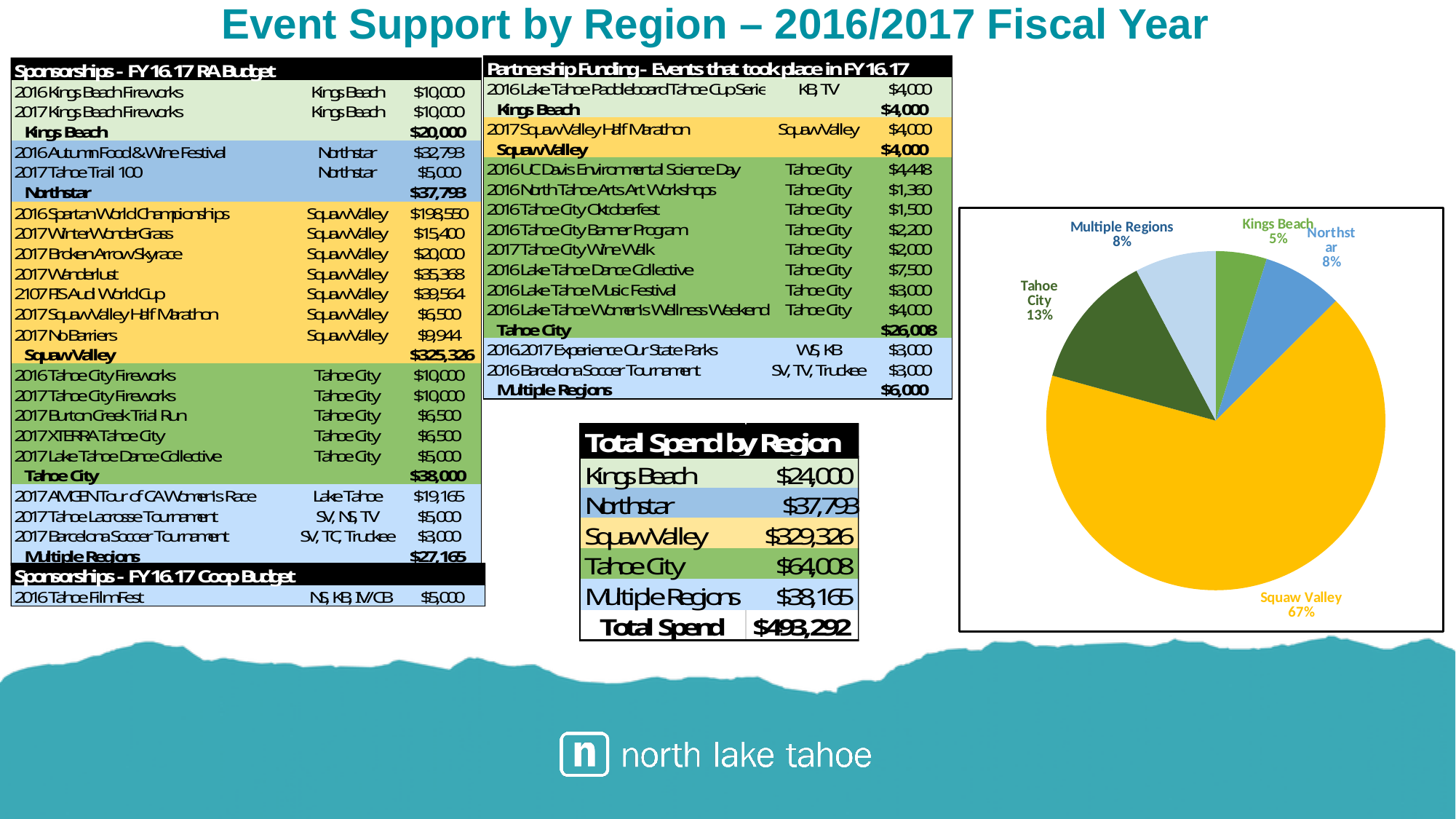
Which region has the smallest slice in the pie chart? Kings Beach Which region has the largest slice in the pie chart? Squaw Valley What share of the pie chart does Tahoe City represent? 13% In the pie chart, what is the difference in percentage points between Multiple Regions and Kings Beach? 3 What share of the pie chart does Kings Beach represent? 5% In the pie chart, what is the difference in percentage points between Squaw Valley and Tahoe City? 54 What share of the pie chart does Squaw Valley represent? 67% What kind of chart is shown on the slide? pie chart What colour is the Squaw Valley slice in the pie chart? yellow In the pie chart, which is larger: Tahoe City or Northstar? Tahoe City How many slices does the pie chart have? 5